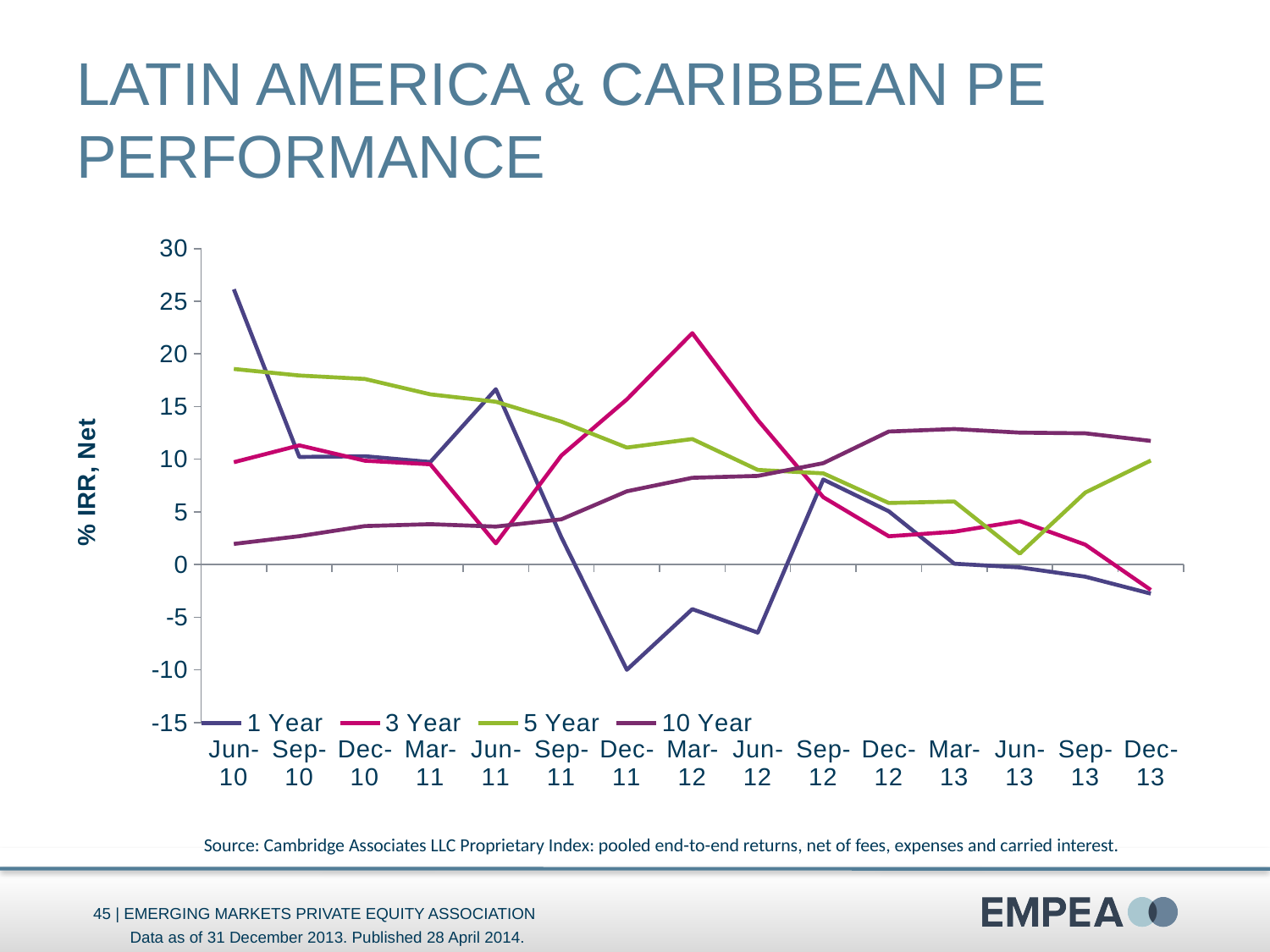
How many series does the legend list? 4 At Jun-10, which is larger: the 5 Year value or the 10 Year value? 5 Year Which series has the lowest value at Dec-11? 1 Year What kind of chart is shown on the slide? line chart Is the value for the 1 Year series at Dec-11 greater or less than -5? less What is the label on the y axis? % IRR, Net Which series has the highest value at Dec-13? 10 Year How many dates are plotted along the x axis? 15 At which date does the 3 Year series reach its highest value? Mar-12 Does the 10 Year series generally rise or fall from Jun-10 to Dec-12? rise Is the value for the 1 Year series at Jun-10 greater or less than 25? greater Is the value for the 3 Year series at Mar-12 greater or less than 20? greater